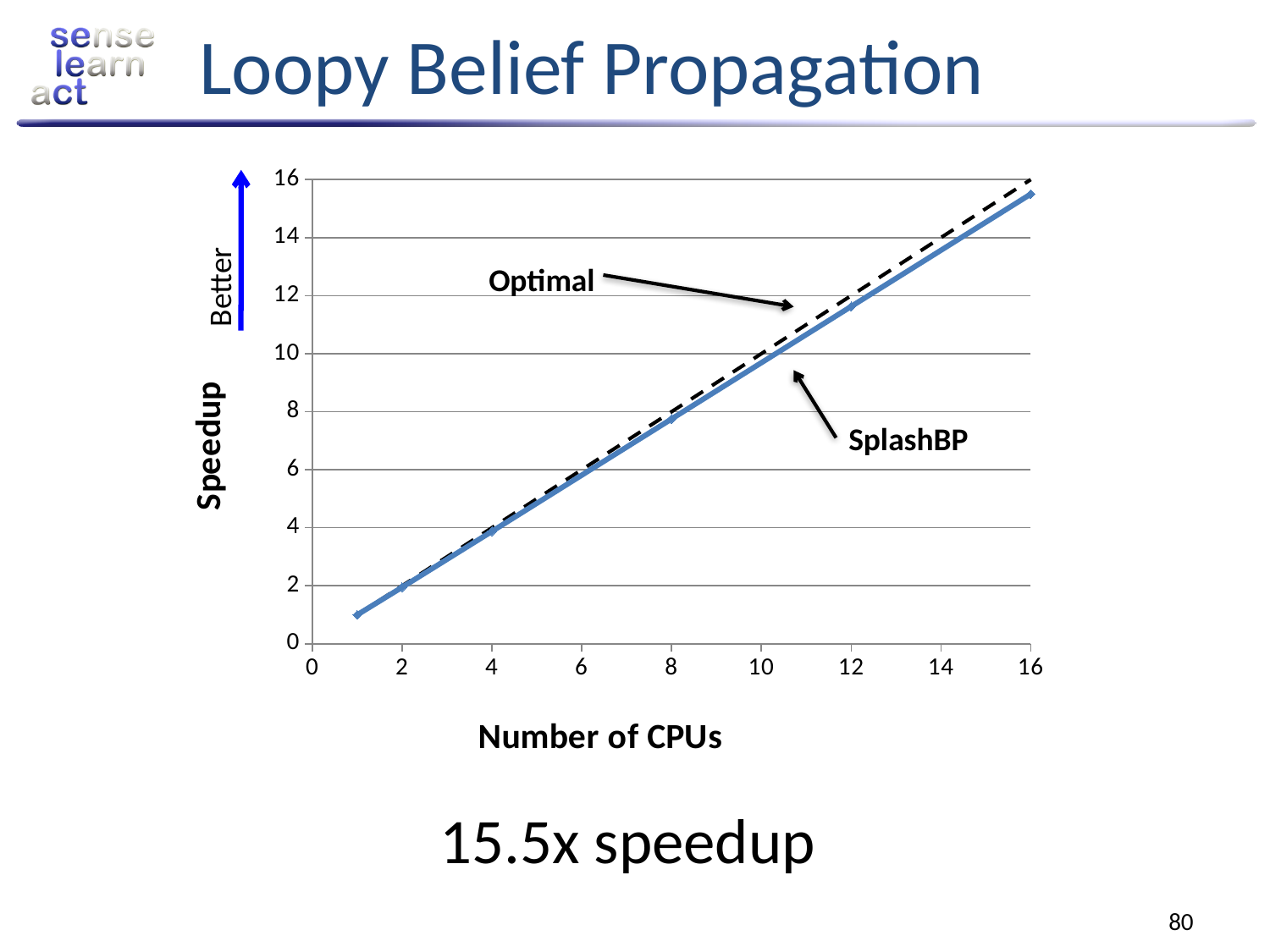
How many lines (series) are plotted on the chart? 2 Is the Optimal speedup at 8 CPUs greater or less than 6? greater Is the SplashBP speedup at 16 CPUs greater or less than 14? greater Is the SplashBP speedup at 8 CPUs greater or less than 10? less Which series reaches the highest speedup on the chart? Optimal What is the title of the y axis of the chart? Speedup What speedup does the slide report for SplashBP? 15.5x What kind of chart is shown on the slide? line chart At 16 CPUs, which line is higher, Optimal or SplashBP? Optimal What is the title of the x axis of the chart? Number of CPUs Does the SplashBP speedup rise or fall as the number of CPUs increases? rises